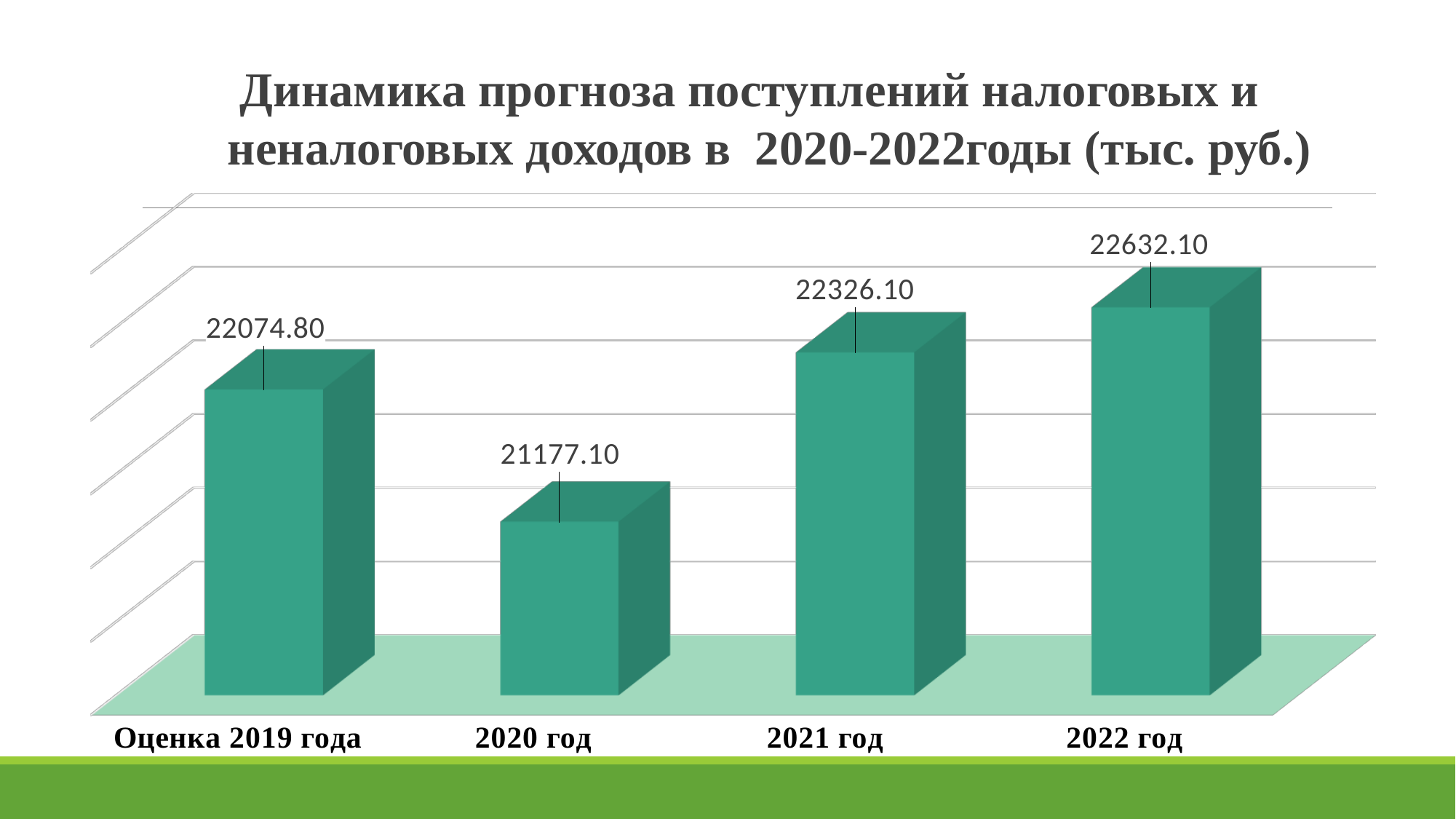
Which category has the highest value? 2022 год How many categories are shown on the chart? 4 Do the values rise or fall from 2020 год to 2022 год? Rise What is the difference between the values for 2022 год and 2021 год? 306.00 What is the value for 2022 год? 22632.10 What is the value for 2021 год? 22326.10 What is the difference between the values for Оценка 2019 года and 2020 год? 897.70 Which is larger, the value for 2021 год or the value for Оценка 2019 года? 2021 год What is the value for 2020 год? 21177.10 What is the value for Оценка 2019 года? 22074.80 What kind of chart is shown on the slide? Bar chart Which category has the lowest value? 2020 год